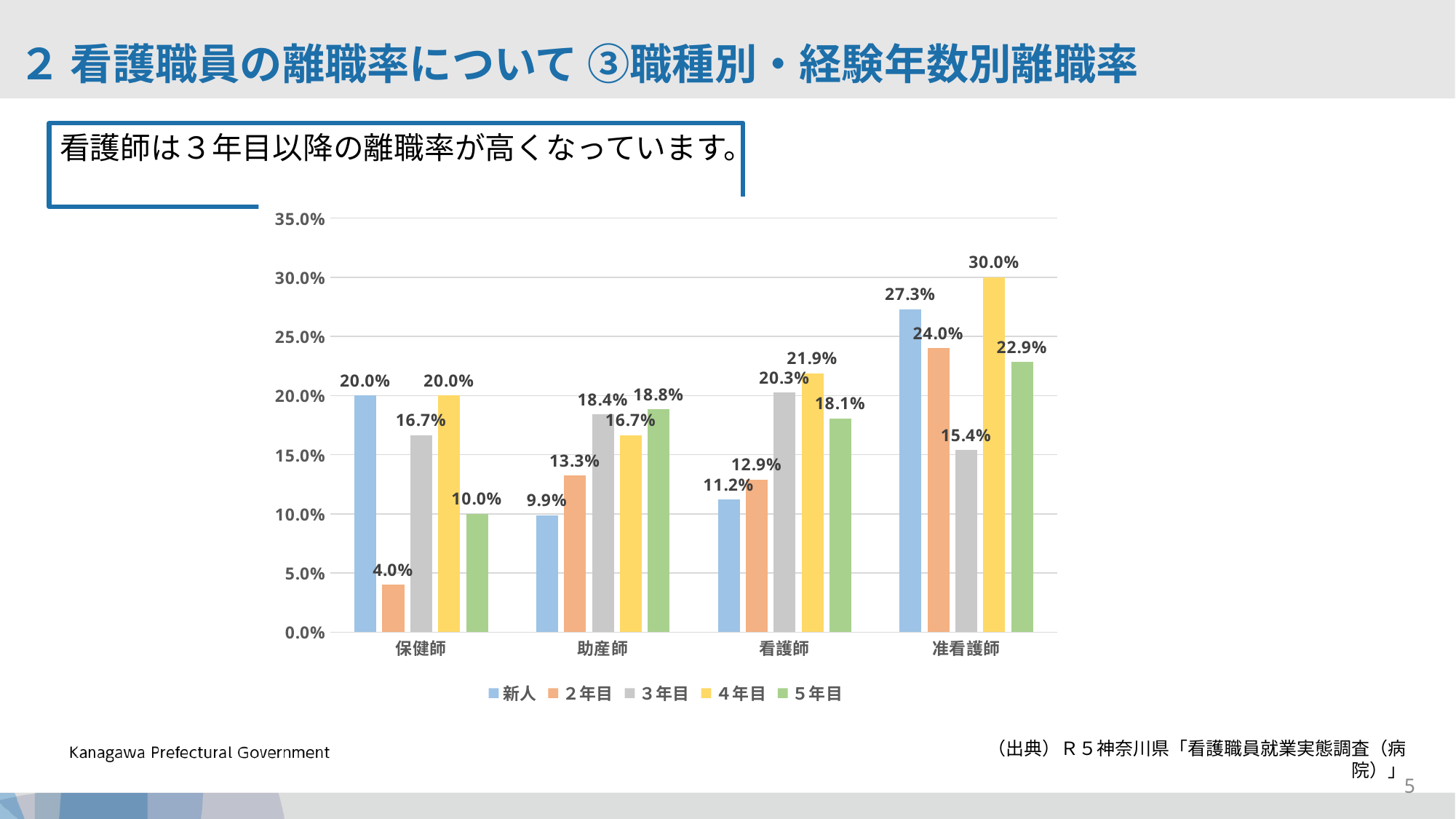
What is the value for 2年目 in the 保健師 category? 4.0% What is the difference between the 4年目 and 新人 values in the 准看護師 category? 2.7% What kind of chart is shown on the slide? Bar chart Which series has the lowest value in the 保健師 category? 2年目 Which category has the highest 新人 value? 准看護師 What is the value for 新人 in the 准看護師 category? 27.3% Which is larger in the 看護師 category: the 3年目 value or the 5年目 value? 3年目 How many series does the legend list? 5 Which series has the highest value in the 准看護師 category? 4年目 How many categories are shown on the x axis? 4 What is the value for 5年目 in the 助産師 category? 18.8% What is the value for 4年目 in the 看護師 category? 21.9%